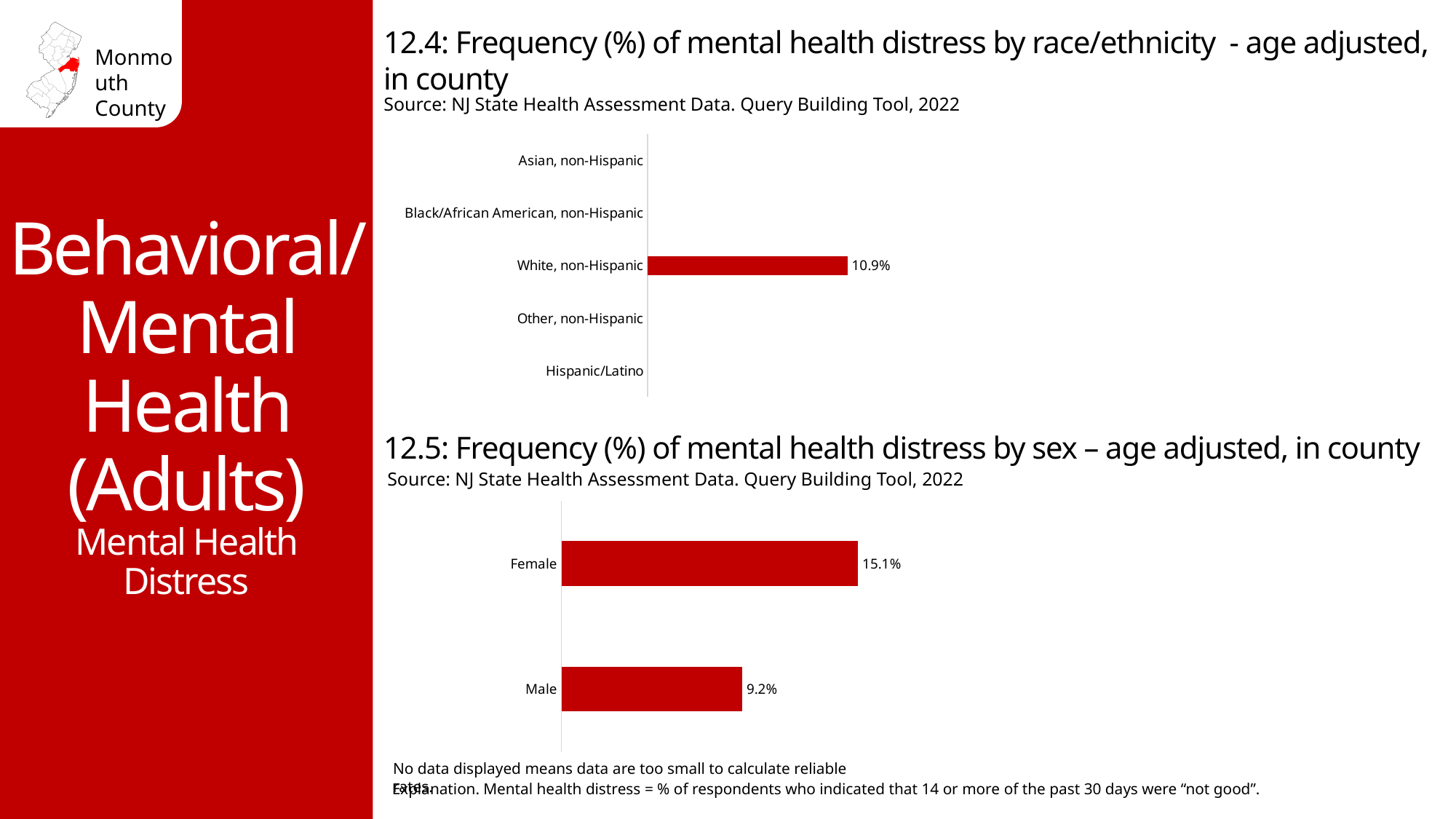
In chart 12.5 (mental health distress by sex), is the value for Female or Male larger? Female In chart 12.5 (mental health distress by sex), which category has the highest value? Female What kind of chart is chart 12.5 (mental health distress by sex)? Bar chart In chart 12.5 (mental health distress by sex), what is the value for Male? 9.2% In chart 12.5 (mental health distress by sex), which category has the lowest value? Male In chart 12.5 (mental health distress by sex), what is the value for Female? 15.1% In chart 12.4 (mental health distress by race/ethnicity), how many race/ethnicity categories are listed on the axis? 5 In chart 12.4 (mental health distress by race/ethnicity), what is the value for White, non-Hispanic? 10.9% In chart 12.5 (mental health distress by sex), how many categories are shown? 2 What kind of chart is chart 12.4 (mental health distress by race/ethnicity)? Bar chart In chart 12.5 (mental health distress by sex), what is the difference between the Female and Male values? 5.9% In chart 12.4 (mental health distress by race/ethnicity), which category is the only one with a bar displayed? White, non-Hispanic